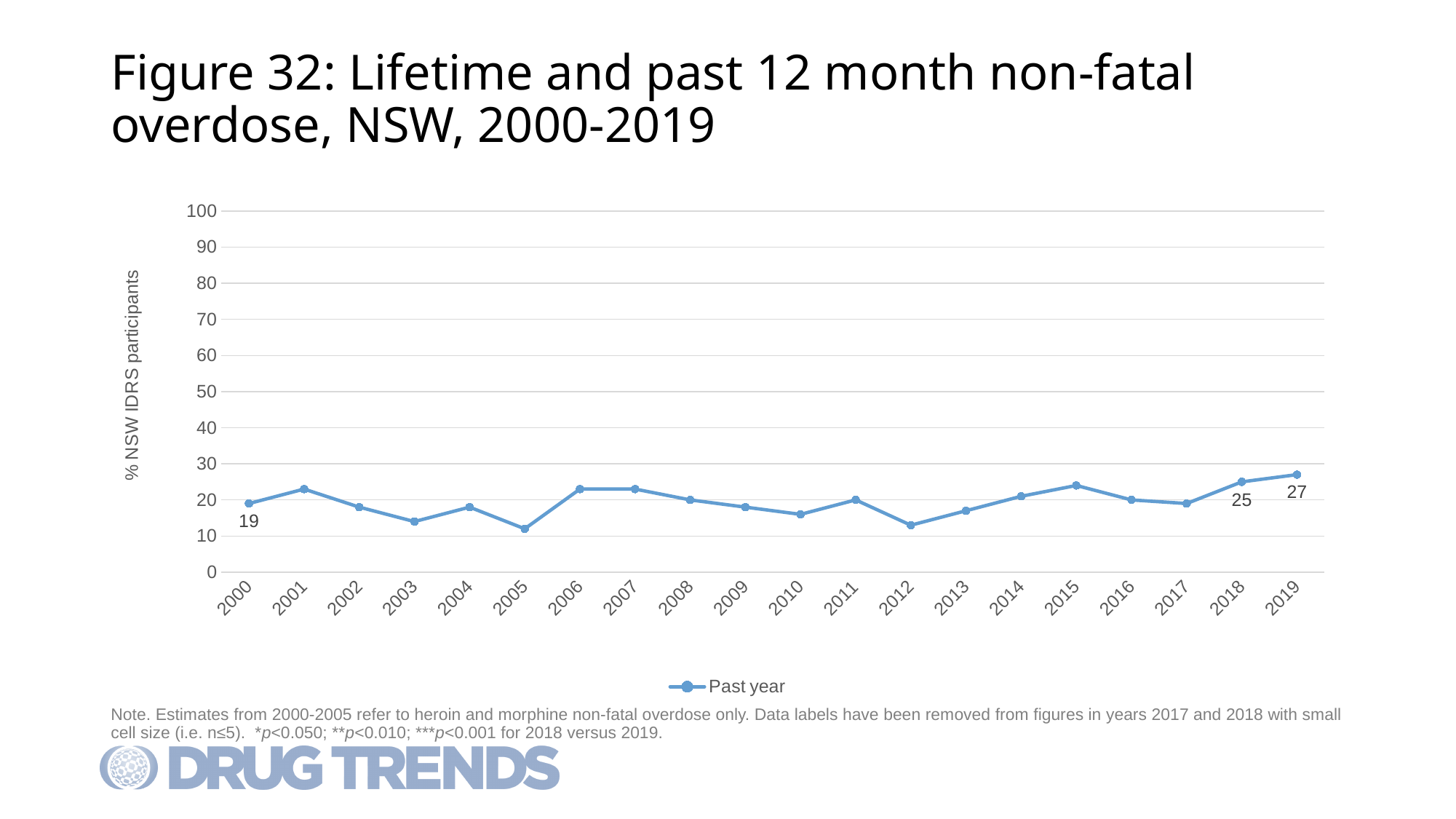
Is the value for 2005 greater or less than 20? less What kind of chart is shown? Line chart What is the value for 2019? 27 How many years are plotted on the x axis? 20 What is the value for 2018? 25 What is the difference between the values for 2019 and 2018? 2 How many series does the legend list? 1 Which year has the highest value? 2019 What is the difference between the values for 2019 and 2000? 8 Is the value for 2015 greater or less than 20? greater What is the value for 2000? 19 Which is larger, the value for 2000 or the value for 2018? 2018